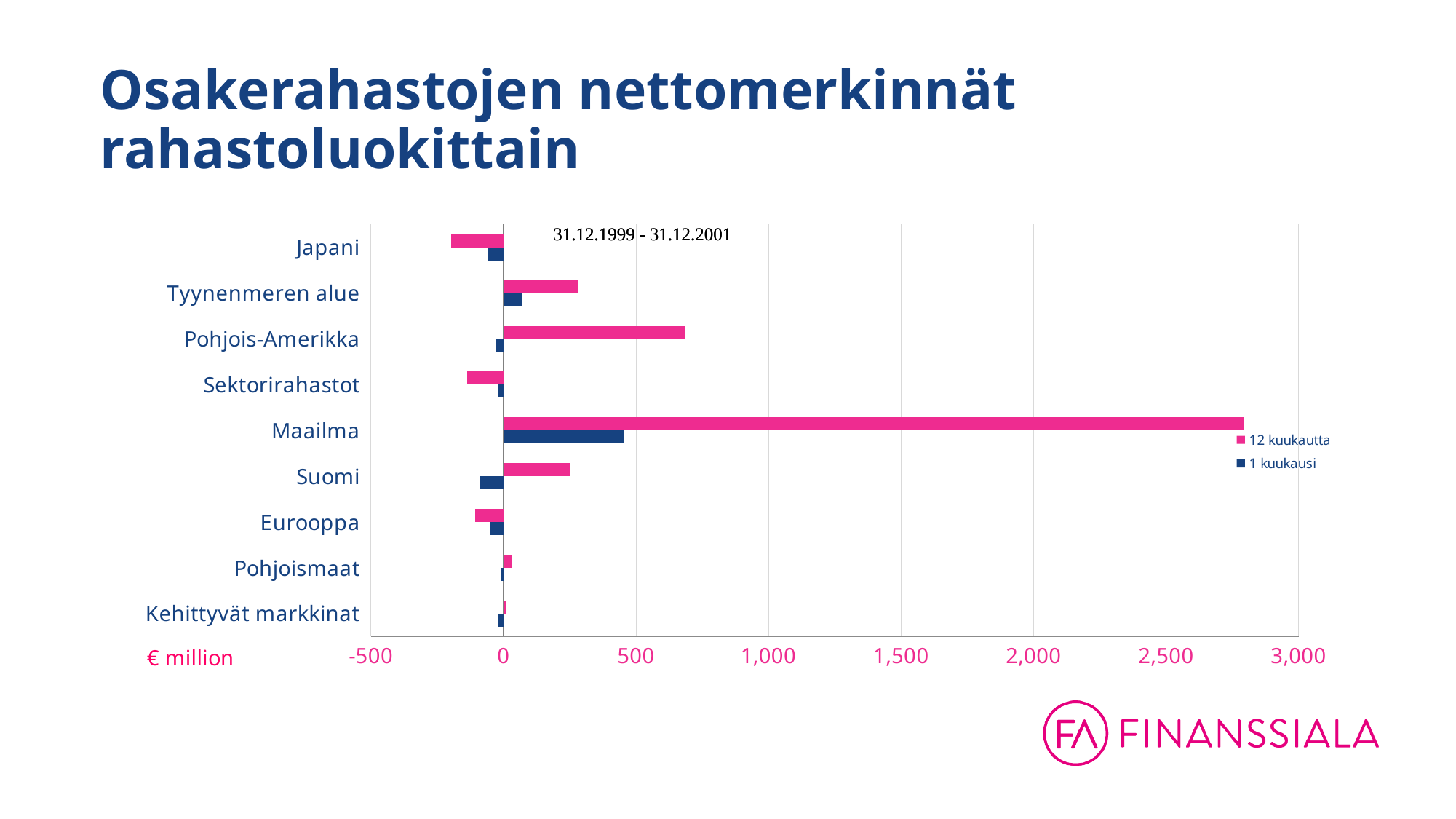
How many series does the chart's legend list? 2 Is the 1 kuukausi value for Maailma greater or less than 500? less Is the 12 kuukautta value for Pohjois-Amerikka greater or less than 500? greater How many fund categories are listed on the chart's vertical axis? 9 What unit is shown for the horizontal axis of the chart? € million For the 12 kuukautta series, which is larger: Pohjois-Amerikka or Suomi? Pohjois-Amerikka Is the 12 kuukautta value for Maailma greater or less than 2,500? greater What kind of chart is shown on the slide? bar chart What date range is printed on the chart? 31.12.1999 - 31.12.2001 Which category has the lowest value for the 12 kuukautta series? Japani Which category has the highest value for the 12 kuukautta series? Maailma